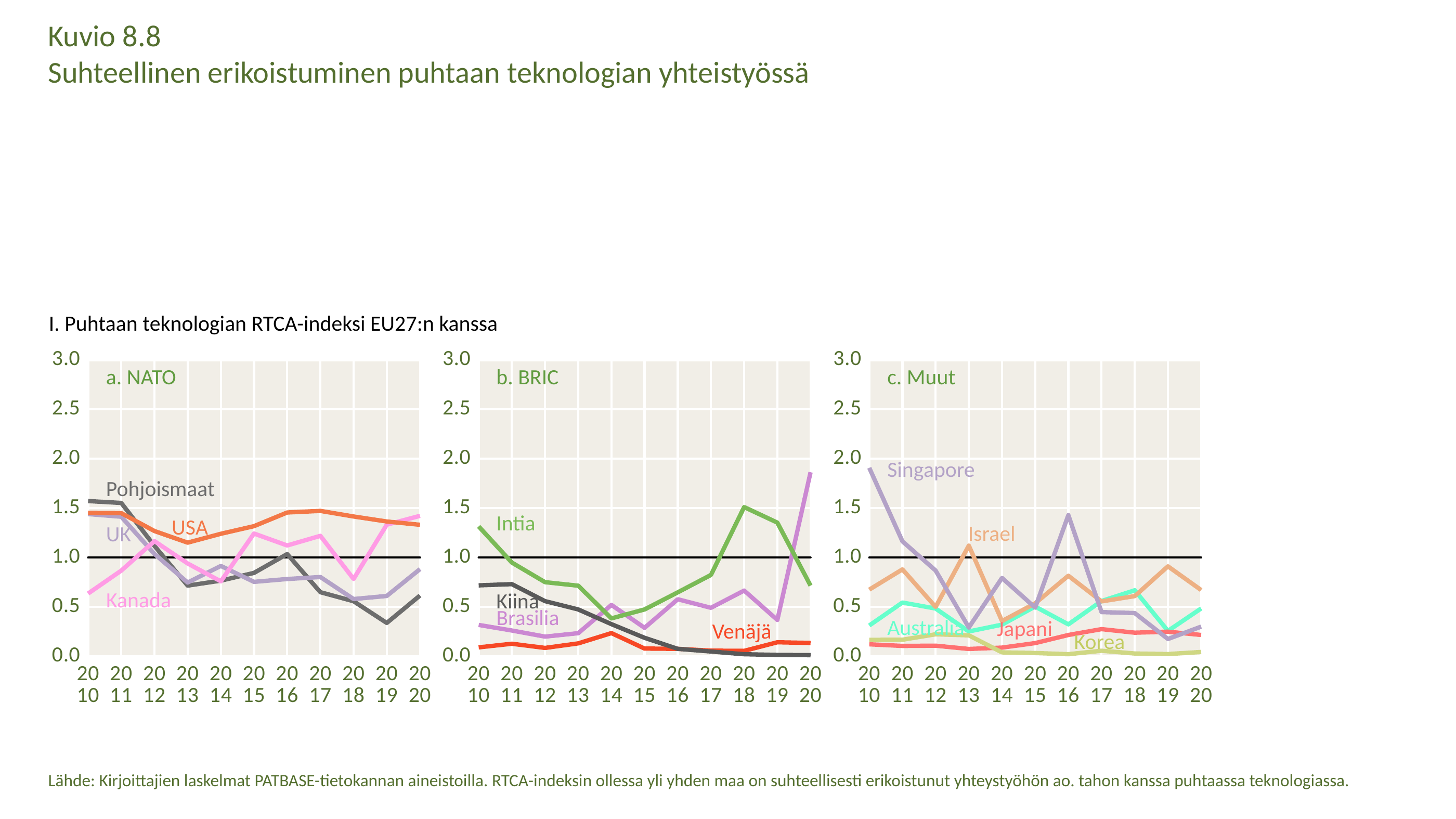
In the "c. Muut" chart, is the value for Singapore in 2010 greater or less than 1.5? greater In the "b. BRIC" chart, is the value for Brasilia in 2020 greater or less than 1.5? greater In the "b. BRIC" chart, does the Kiina line rise or fall from 2010 to 2020? fall In the "a. NATO" chart, which series has the lowest value in 2010? Kanada In the "a. NATO" chart, does the Pohjoismaat line rise or fall from 2010 to 2020? fall How many series are labelled in the "a. NATO" chart? 4 What kind of chart is "a. NATO"? line chart How many series are labelled in the "c. Muut" chart? 5 In the "a. NATO" chart, how many years are plotted along the x axis? 11 In the "a. NATO" chart, is the value for USA in 2010 greater or less than 1.0? greater In the "b. BRIC" chart, which series has the highest value in 2010? Intia In the "b. BRIC" chart, which series has the highest value in 2020? Brasilia